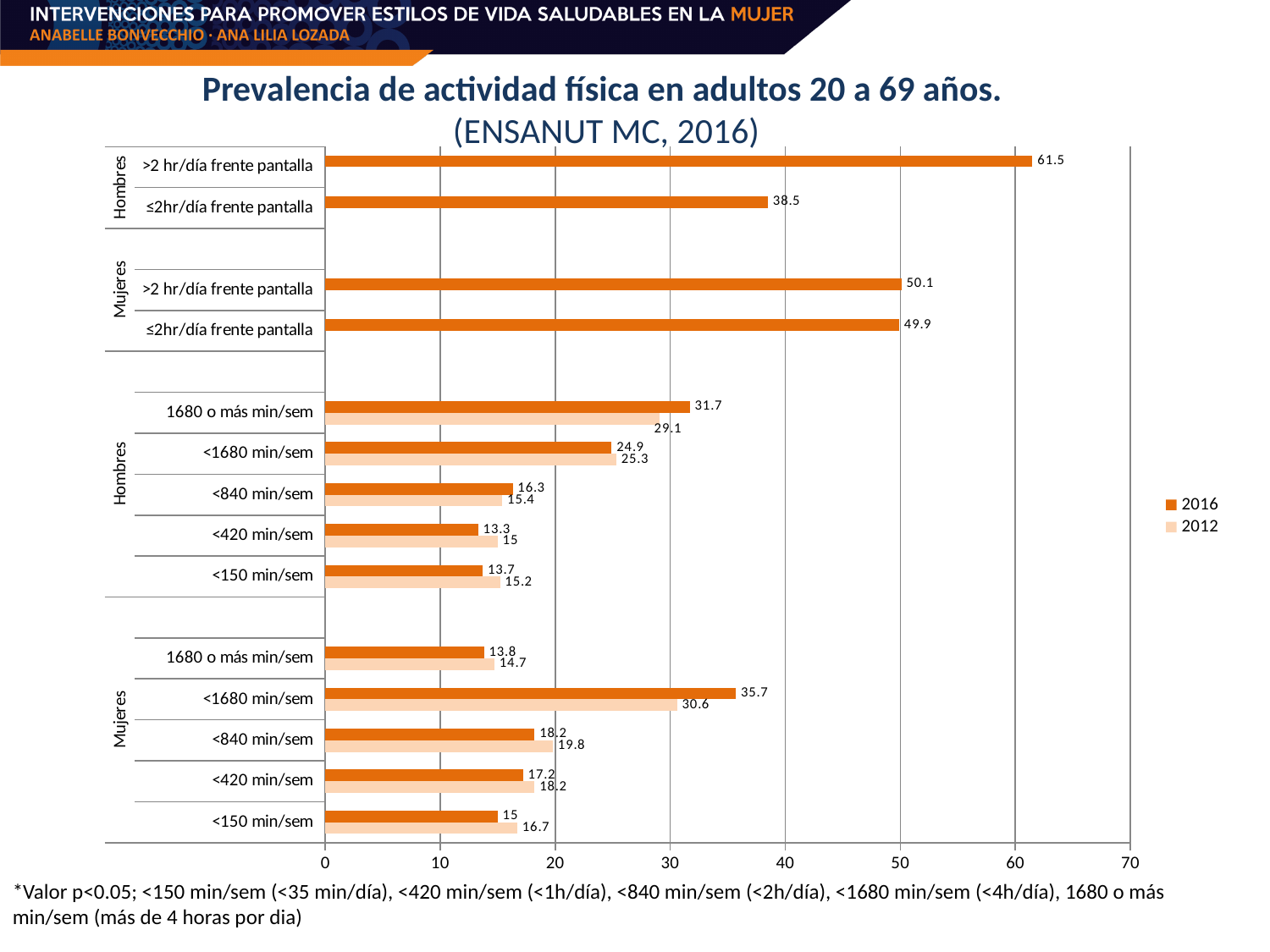
What is the 2016 value for Hombres '>2 hr/día frente pantalla'? 61.5 What is the difference between the 2016 and 2012 values for Hombres '1680 o más min/sem'? 2.6 What kind of chart is shown on the slide? Bar chart For Mujeres '<840 min/sem', which year has the larger value, 2016 or 2012? 2012 What is the 2016 value for Mujeres '≤2hr/día frente pantalla'? 49.9 How many series does the legend list? 2 Among the Hombres min/sem categories, which has the lowest 2016 value? <420 min/sem What is the difference between the 2016 and 2012 values for Mujeres '<1680 min/sem'? 5.1 Is the 2016 value for Hombres '≤2hr/día frente pantalla' greater or less than 40? less What is the 2012 value for Hombres '<150 min/sem'? 15.2 Which category has the highest 2016 value in the chart? Hombres >2 hr/día frente pantalla What is the 2012 value for Mujeres '<1680 min/sem'? 30.6